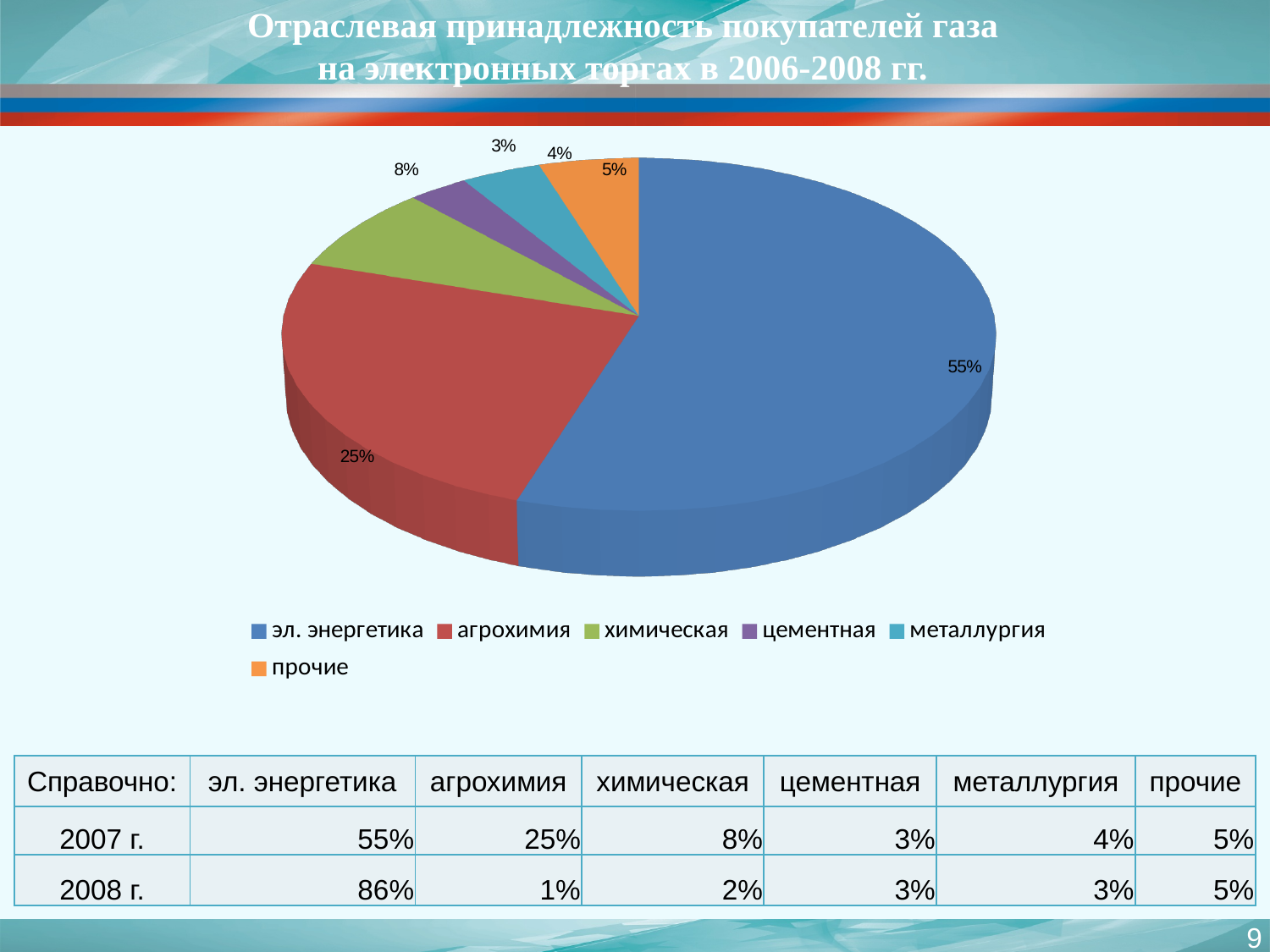
What share of the pie does агрохимия hold? 25% Which is larger, the slice for химическая or the slice for прочие? химическая What share of the pie does металлургия hold? 4% What share of the pie does прочие hold? 5% Which category has the largest slice of the pie? эл. энергетика What colour is the slice for агрохимия? red Which category has the smallest slice of the pie? цементная What share of the pie does химическая hold? 8% What share of the pie does эл. энергетика hold? 55% How many slices does the pie chart have? 6 What kind of chart is shown on the slide? pie chart What is the difference in percentage points between эл. энергетика and агрохимия? 30%